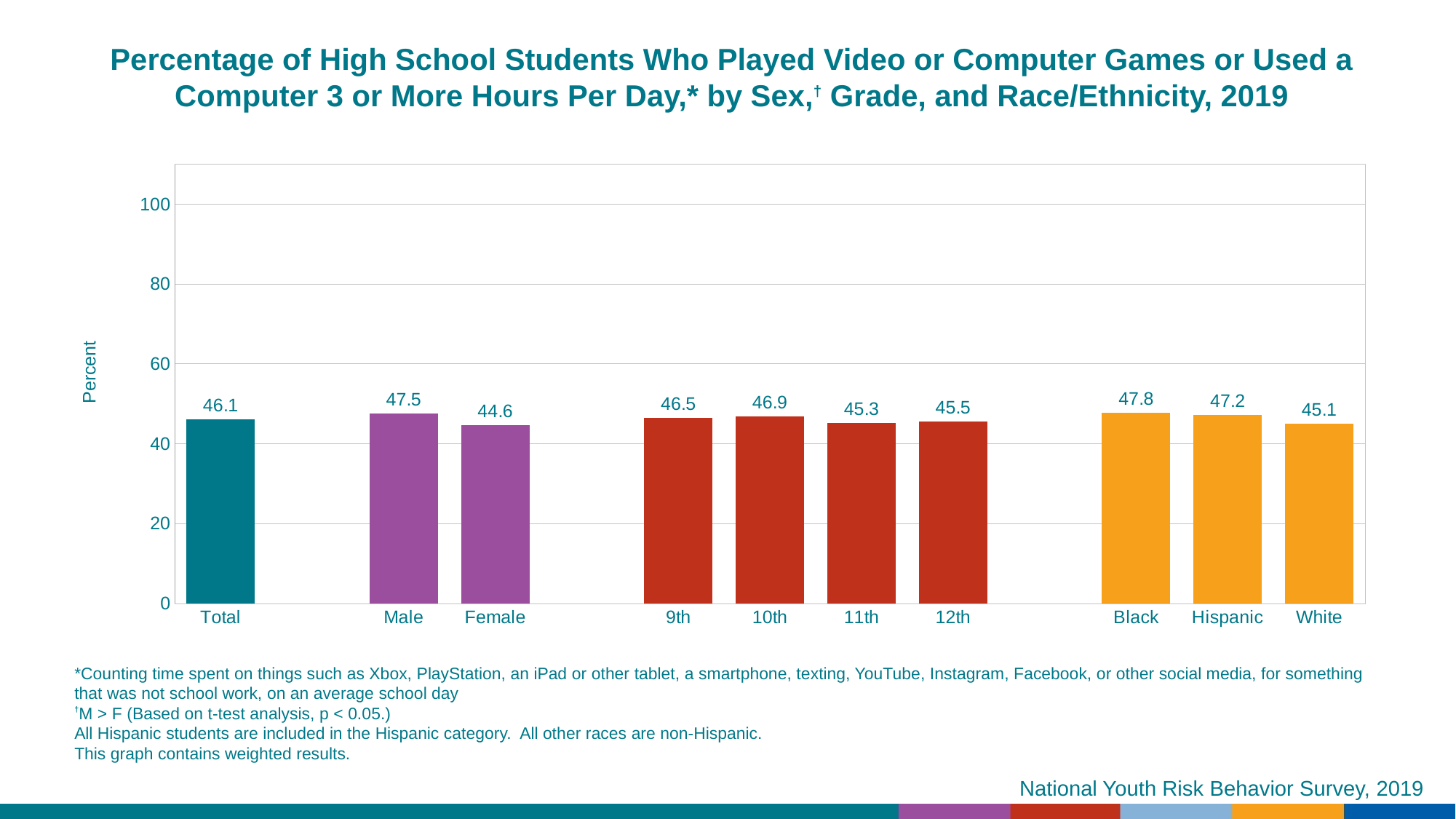
What is the label on the y axis? Percent Which is larger, the value for 9th grade or 11th grade? 9th What kind of chart is this? bar chart What is the value for Female? 44.6 Which category has the highest value? Black What is the value for Hispanic students? 47.2 Which category has the lowest value? Female What is the value for 10th grade? 46.9 How many categories are shown on the x axis? 10 Is the value for White greater or less than 60? less What is the value for Total? 46.1 What is the difference between the Male and Female values? 2.9